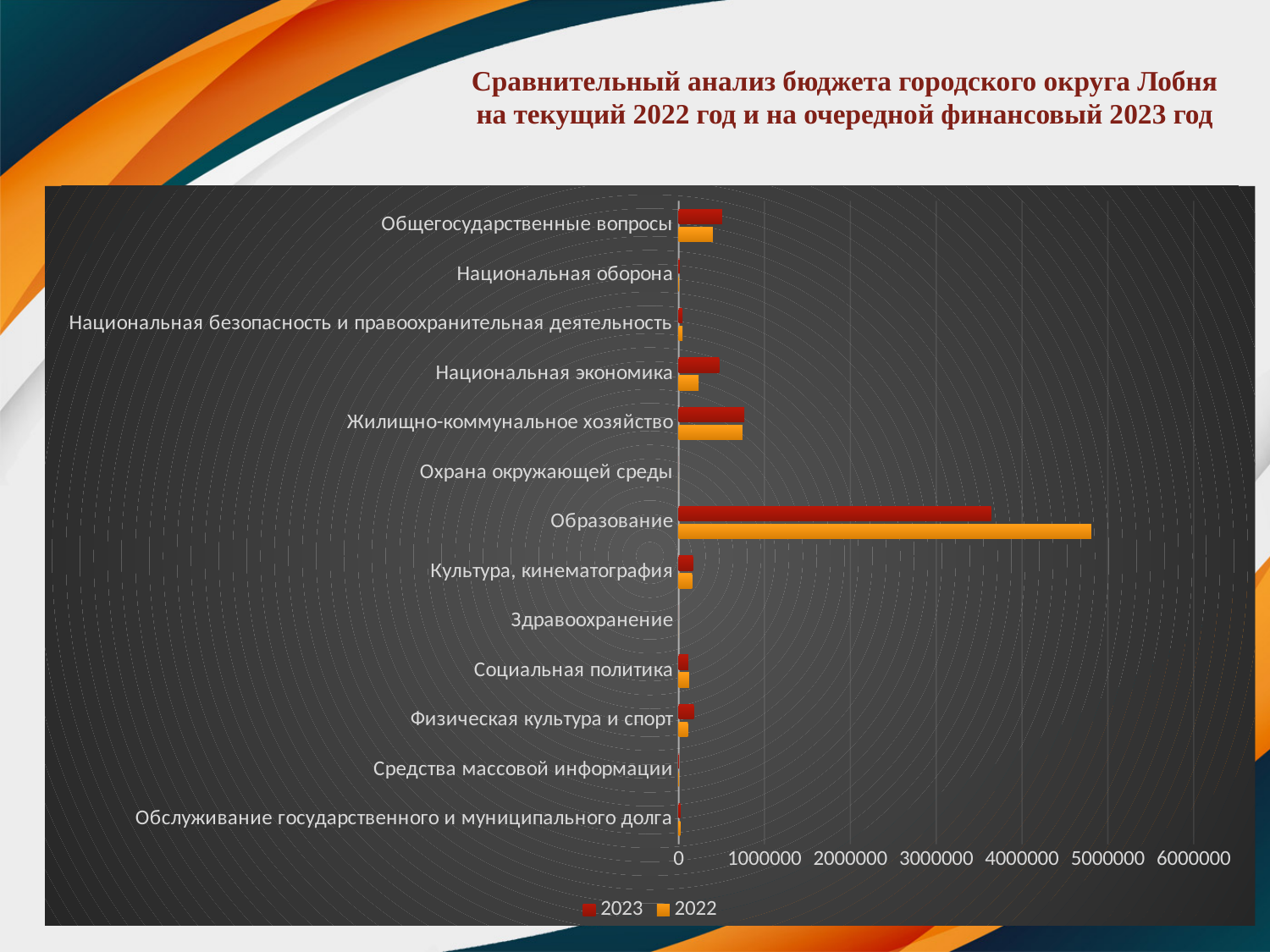
How many series does the legend list? 2 Which two series are listed in the legend? 2023 and 2022 Is the 2023 value for Образование greater or less than 3000000? greater Which category has the highest value for the 2023 series? Образование For Общегосударственные вопросы, which series has the larger value, 2022 or 2023? 2023 Is the 2022 value for Образование greater or less than 4000000? greater What kind of chart is shown on the slide? bar chart How many categories are shown on the vertical axis of the chart? 13 Is the 2023 value for Образование greater or less than 4000000? less For Образование, which series has the larger value, 2022 or 2023? 2022 Which category has the highest value for the 2022 series? Образование